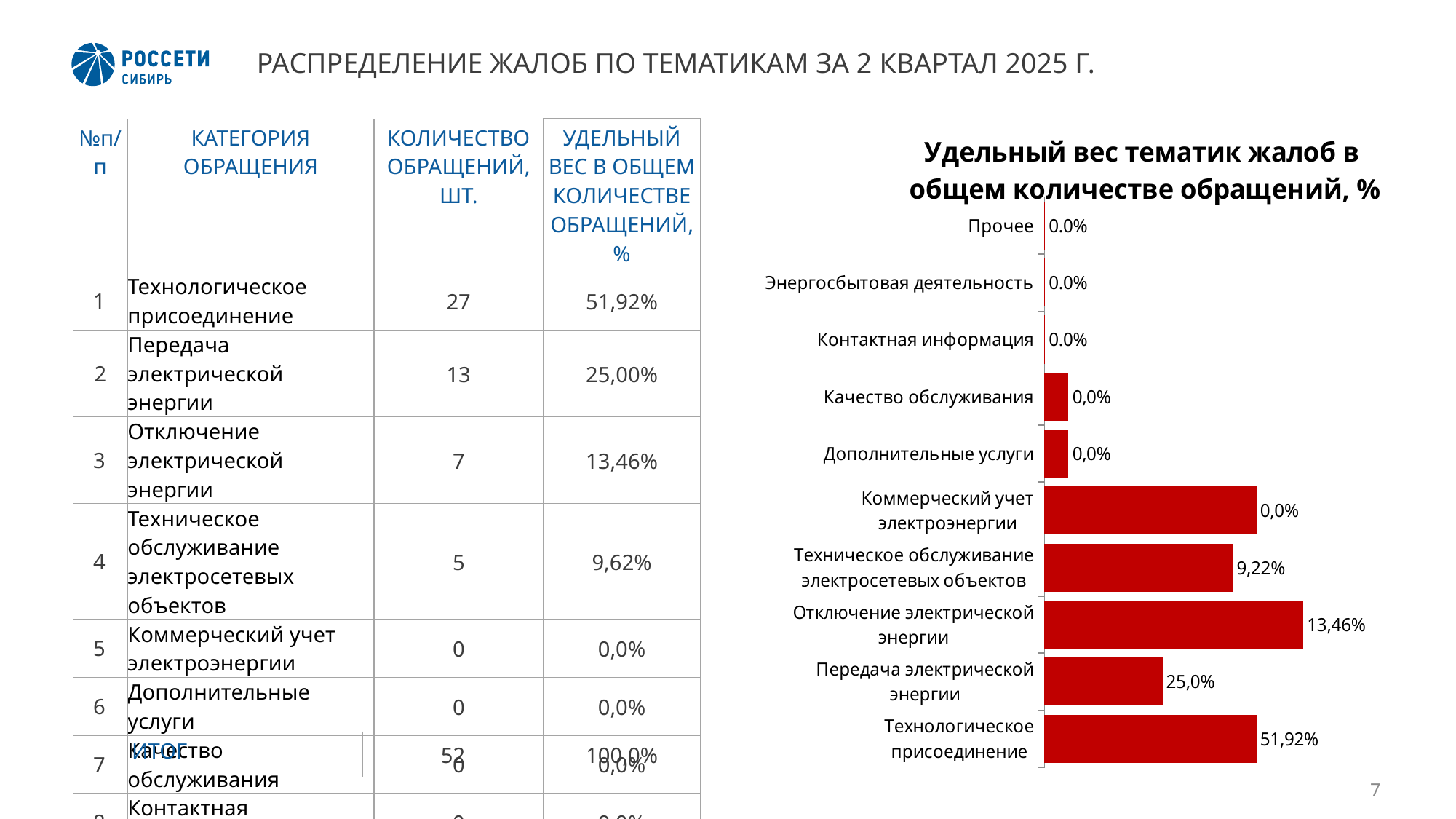
What is the difference between the labelled values for Отключение электрической энергии and Техническое обслуживание электросетевых объектов? 4,24% How many categories are shown in the chart? 10 What is the data label for Отключение электрической энергии in the chart? 13,46% What colour are the bars in the chart? Red What is the data label for Техническое обслуживание электросетевых объектов in the chart? 9,22% What is the data label for Передача электрической энергии in the chart? 25,0% What kind of chart is shown on the slide? Bar chart What is the data label for Прочее in the chart? 0.0% What is the data label for Технологическое присоединение in the chart? 51,92% What is the title of the chart? Удельный вес тематик жалоб в общем количестве обращений, % What is the difference between the labelled values for Технологическое присоединение and Передача электрической энергии? 26,92%